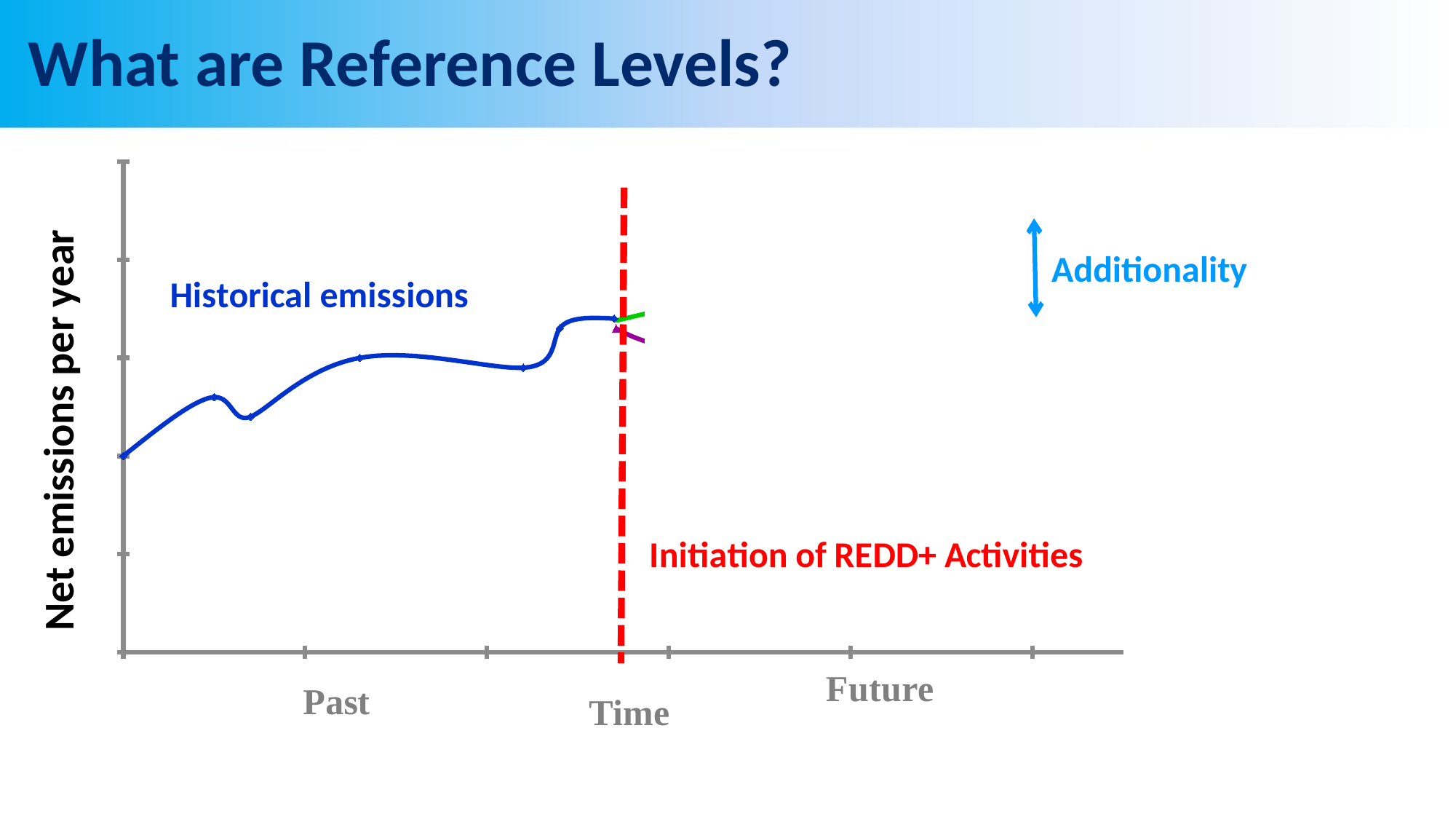
What kind of chart is shown on the slide? line chart What is the label on the vertical axis of the chart? Net emissions per year Do the historical emissions generally rise or fall along the x axis from the past toward the initiation of REDD+ activities? rise What does the red dashed vertical line on the chart mark? Initiation of REDD+ Activities